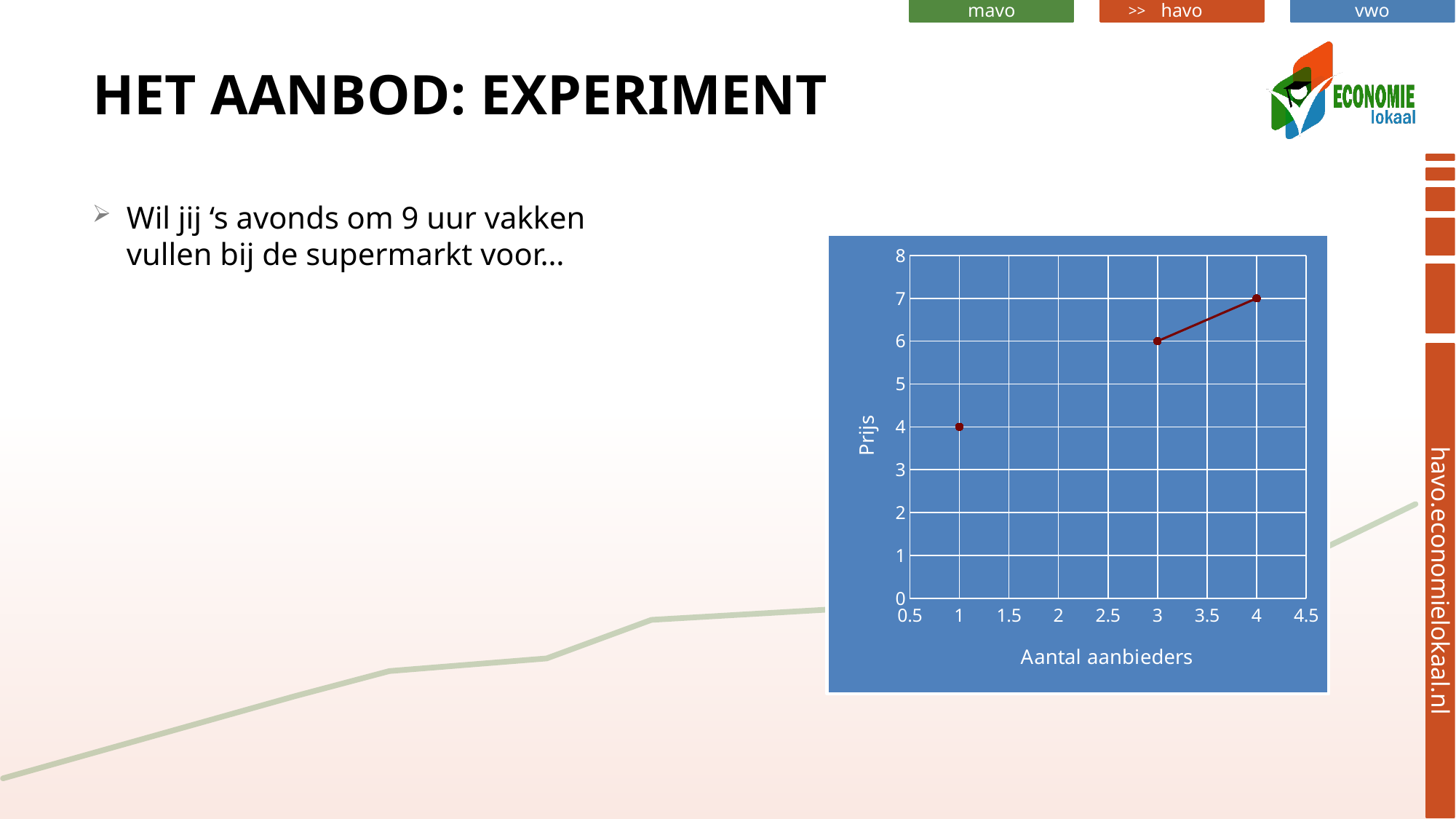
Do the Prijs values rise or fall as Aantal aanbieders increases? rise What is the label of the y axis of the chart? Prijs How many data points are plotted on the chart? 3 What is the Prijs value when Aantal aanbieders is 4? 7 What is the Prijs value when Aantal aanbieders is 1? 4 What is the label of the x axis of the chart? Aantal aanbieders At which Aantal aanbieders value is the Prijs lowest? 1 What is the difference in Prijs between Aantal aanbieders 4 and Aantal aanbieders 1? 3 What is the highest value shown on the y axis of the chart? 8 At which Aantal aanbieders value is the Prijs highest? 4 What is the Prijs value when Aantal aanbieders is 3? 6 Which has a higher Prijs: Aantal aanbieders 3 or Aantal aanbieders 1? Aantal aanbieders 3